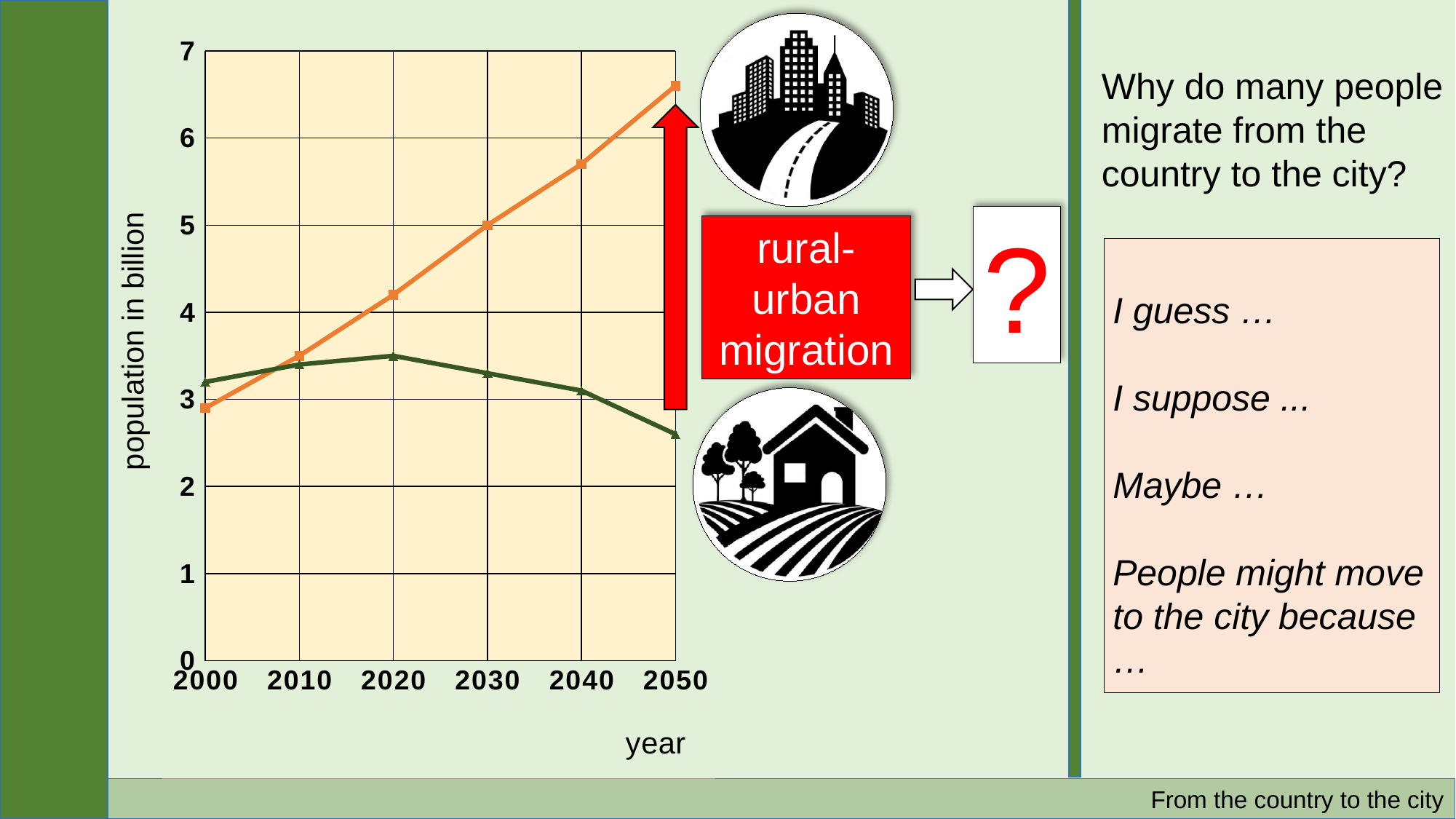
Is the value of the orange line in 2050 greater or less than 6? greater What is the value of the orange line in 2030? 5 Does the orange line rise or fall from 2000 to 2050? rise Is the value of the orange line in 2040 greater or less than 5? greater How many years are marked along the x axis of the chart? 6 Is the value of the green line in 2050 greater or less than 3? less Does the green line rise or fall from 2020 to 2050? fall In 2050, which line has the higher value, the orange line or the green line? the orange line What is the label of the y axis of the chart? population in billion In 2000, which line has the higher value, the orange line or the green line? the green line What kind of chart is shown on the slide? line chart